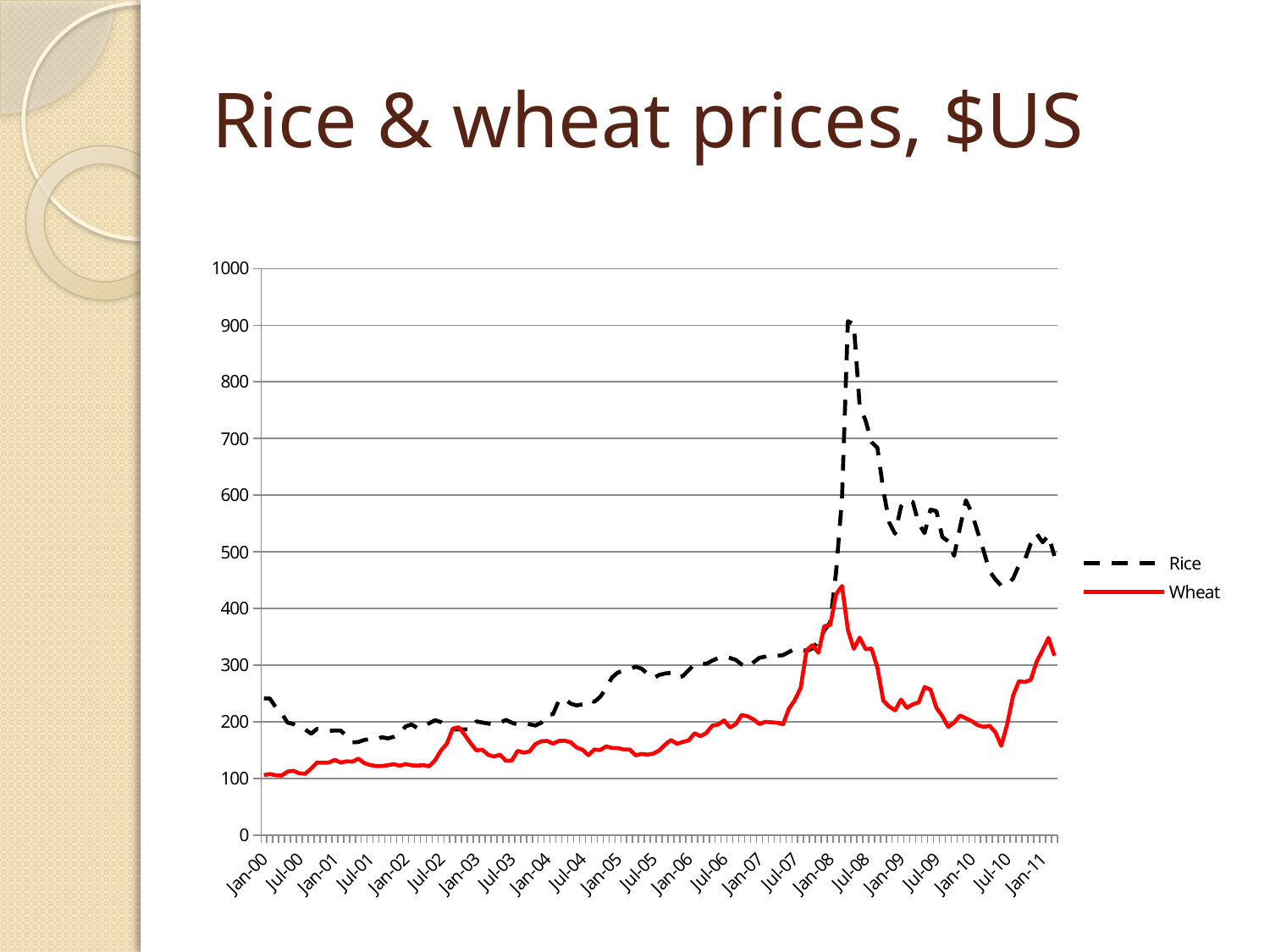
Does the Wheat price generally rise or fall from Jan-00 to Jan-08? Rise What kind of chart is shown on the slide? Line chart How many series does the legend list? 2 Which series is drawn as a dashed black line? Rice Is the value for Wheat at Jan-00 greater or less than 200? less Is the peak value for Rice around 2008 greater or less than 800? greater Which series reaches the highest value on the chart? Rice What is the title of the chart? Rice & wheat prices, $US Is the value for Rice at Jan-00 greater or less than 200? greater